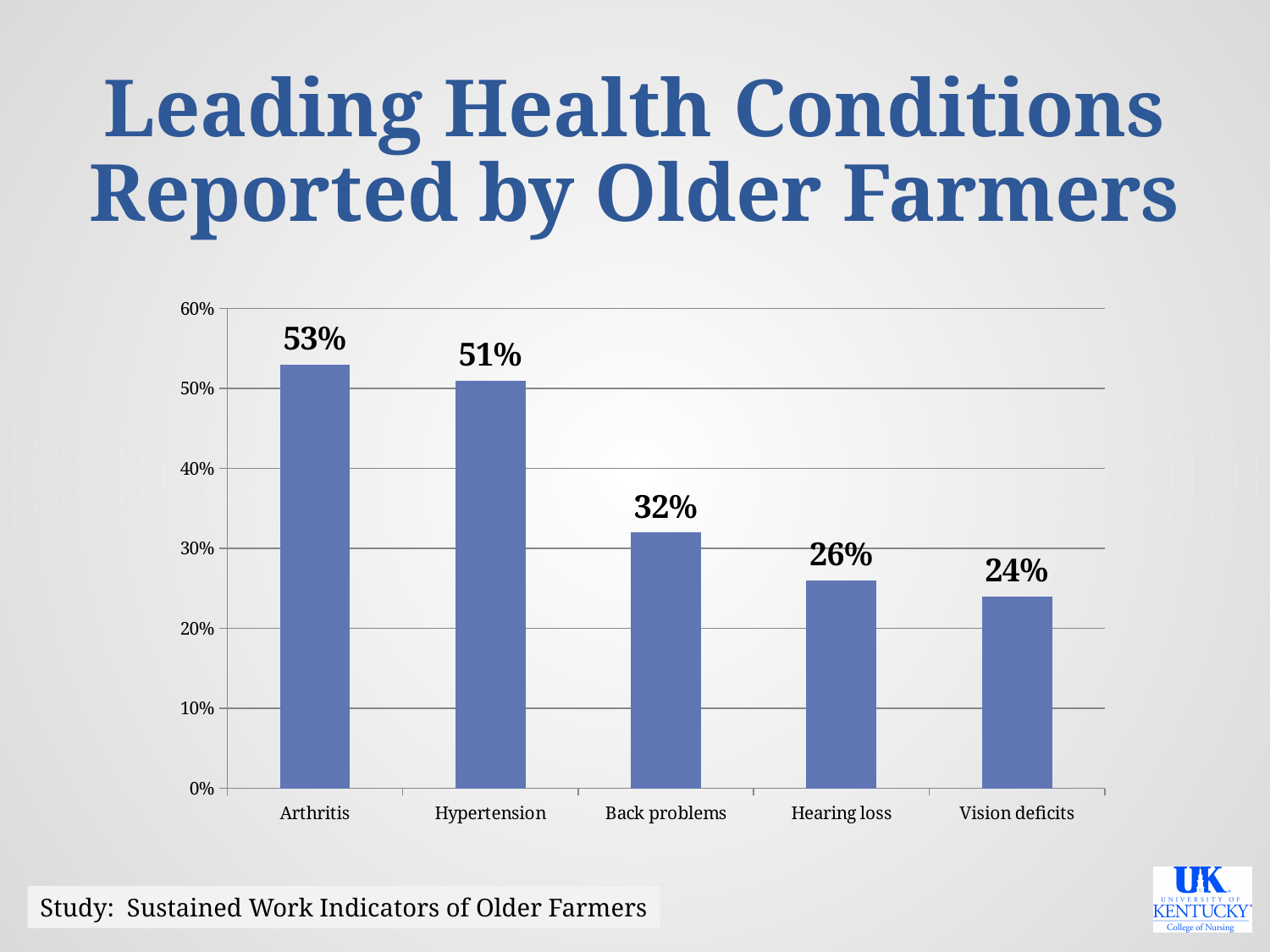
What percentage of older farmers reported arthritis? 53% Which health condition has the highest reported percentage? Arthritis What is the value shown for Hypertension? 51% Is the value for Hypertension greater or less than 40%? greater What is the difference between the values for Hearing loss and Vision deficits? 2% Which is larger, the value for Back problems or the value for Hearing loss? Back problems What is the value for Vision deficits? 24% Which health condition has the lowest reported percentage? Vision deficits What is the difference between the percentages for Arthritis and Back problems? 21% What kind of chart is shown on the slide? Bar chart What percentage is shown for Back problems? 32% How many health conditions are shown on the chart? 5